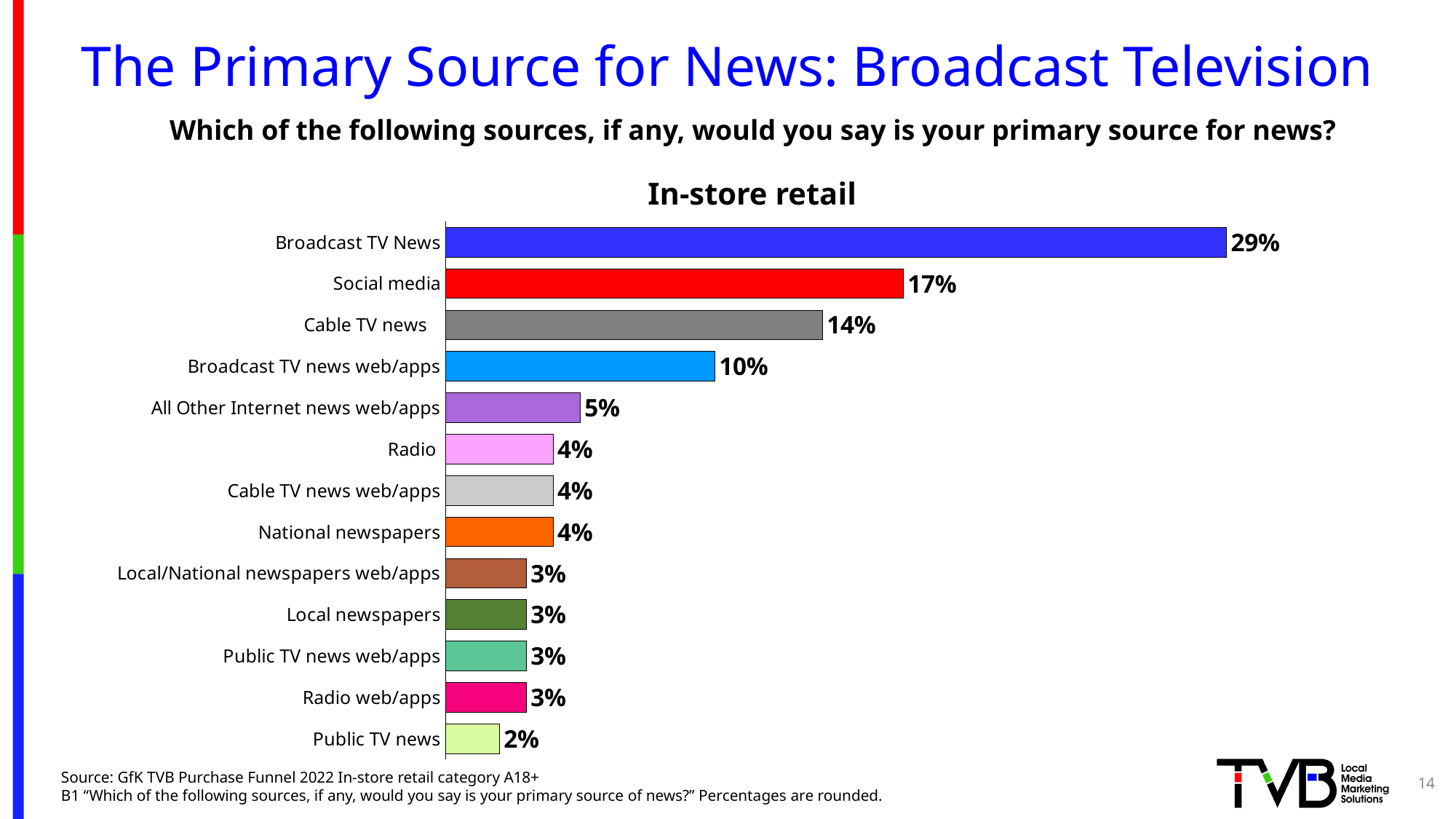
What is the title of the chart? In-store retail Which source has the lowest value in the chart? Public TV news Which source has the highest value in the chart? Broadcast TV News What percentage of respondents named Broadcast TV News as their primary source for news? 29% What kind of chart is shown on the slide? Bar chart Which is larger, the value for Social media or the value for Cable TV news? Social media What is the value shown for Social media? 17% What is the value shown for Public TV news? 2% What is the value shown for Cable TV news? 14% What is the difference between the values for Broadcast TV News and Social media? 12% What is the difference between the values for Cable TV news and Broadcast TV news web/apps? 4% How many sources (categories) are shown in the chart? 13